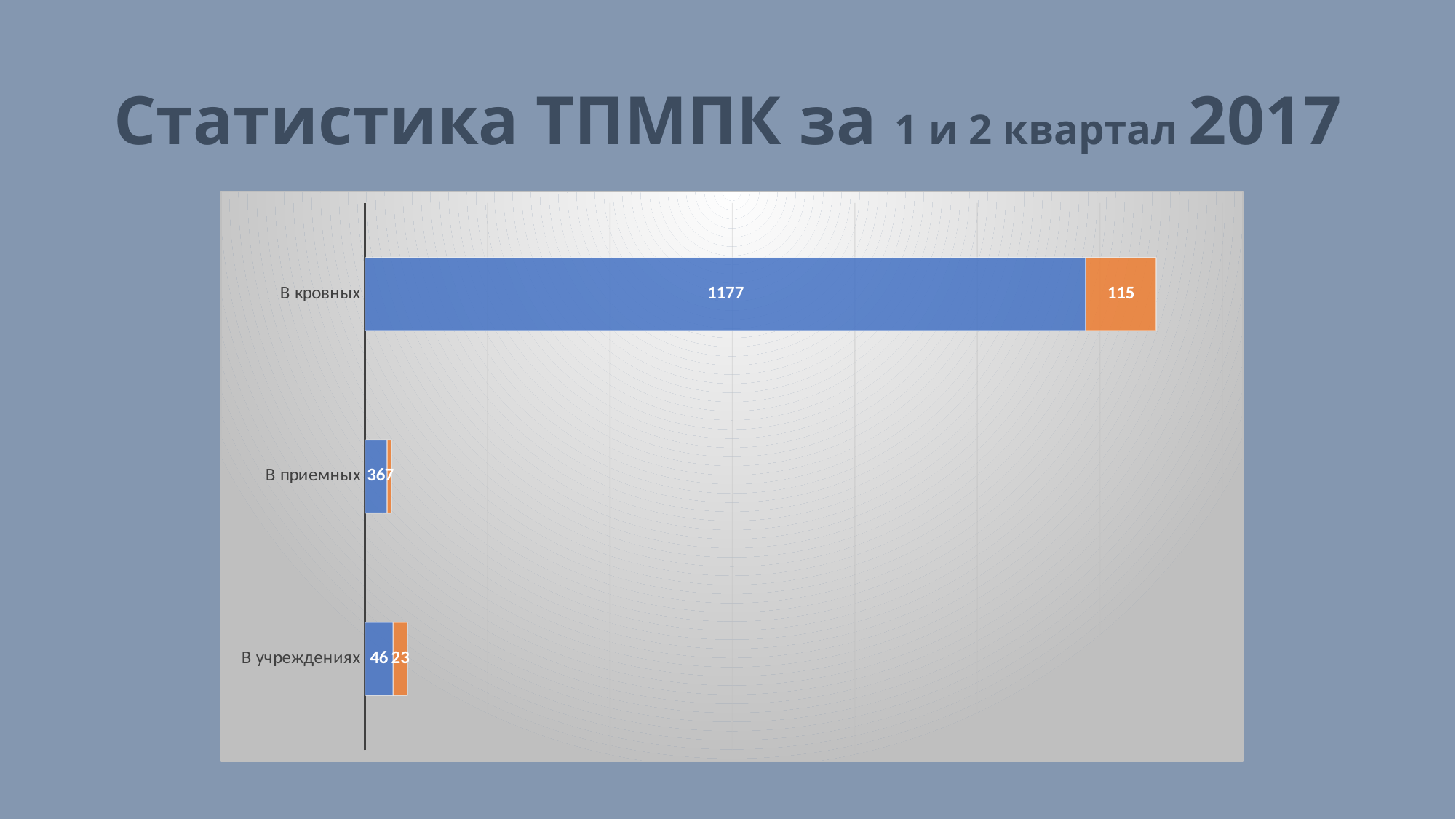
What is the value of the orange segment for В кровных? 115 What is the value of the blue segment for В учреждениях? 46 What is the total of the stacked bar for В кровных? 1292 What is the title of the slide? Статистика ТПМПК за 1 и 2 квартал 2017 What is the total of the stacked bar for В учреждениях? 69 How many categories are shown on the chart? 3 For В учреждениях, which segment is larger, the blue or the orange? blue What kind of chart is shown on the slide? bar chart What is the value of the blue segment for В кровных? 1177 Which category has the longest bar overall? В кровных What is the value of the orange segment for В учреждениях? 23 What is the difference between the blue and orange segments for В кровных? 1062